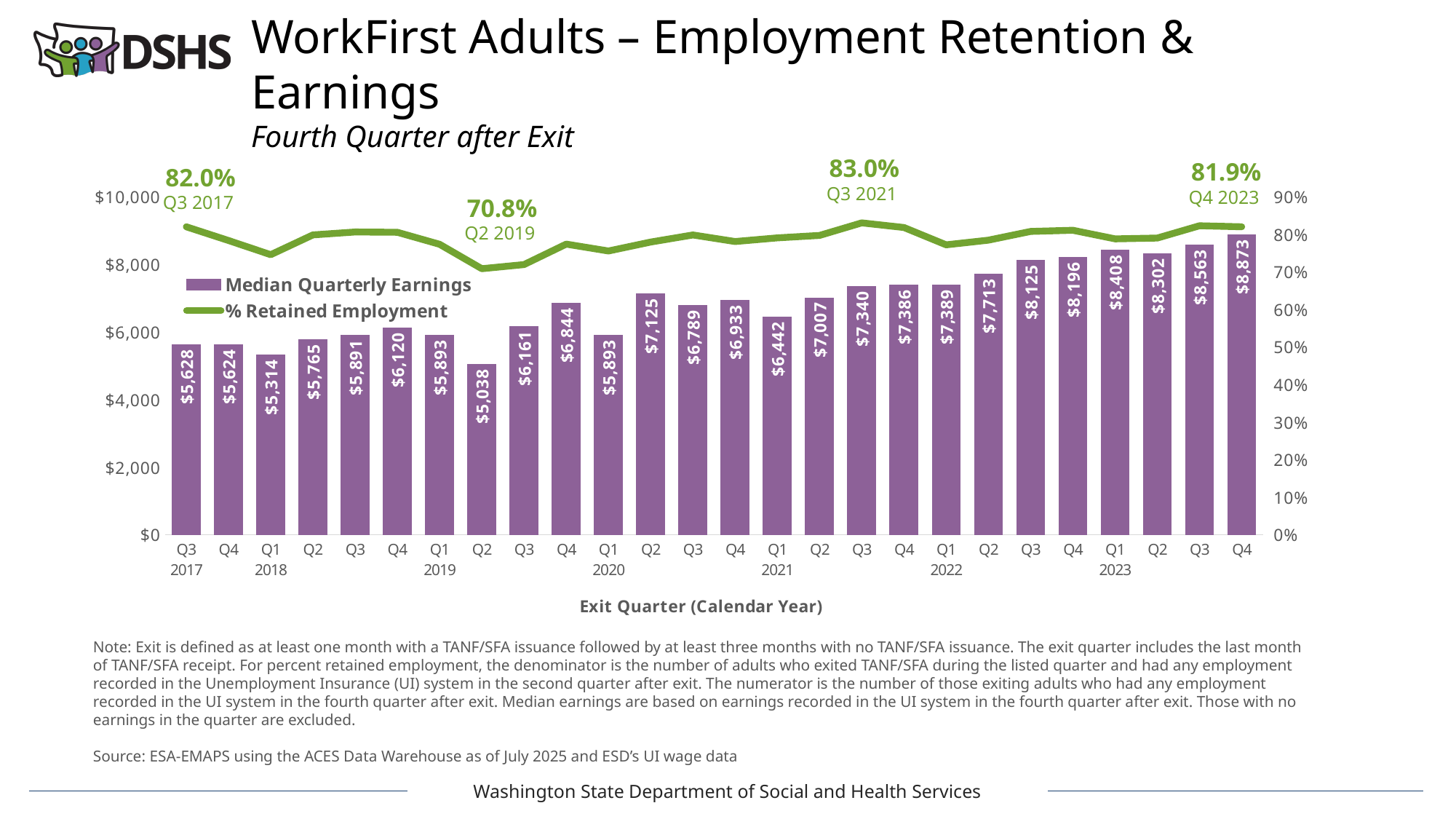
Which exit quarter has the highest median quarterly earnings? Q4 2023 What is the % retained employment labeled for Q3 2021? 83.0% Which has higher median quarterly earnings, Q4 2019 or Q3 2020? Q4 2019 What is the % retained employment labeled for Q2 2019? 70.8% How many series does the legend list? 2 What kind of chart is this? A combination bar and line chart What is the median quarterly earnings value for Q2 2019? $5,038 Is the % retained employment for Q1 2018 greater or less than 80%? less What is the difference in median quarterly earnings between Q4 2023 and Q3 2017? $3,245 Which exit quarter has the lowest median quarterly earnings? Q2 2019 What is the median quarterly earnings value for Q4 2023? $8,873 How many exit quarters are plotted on the chart? 26